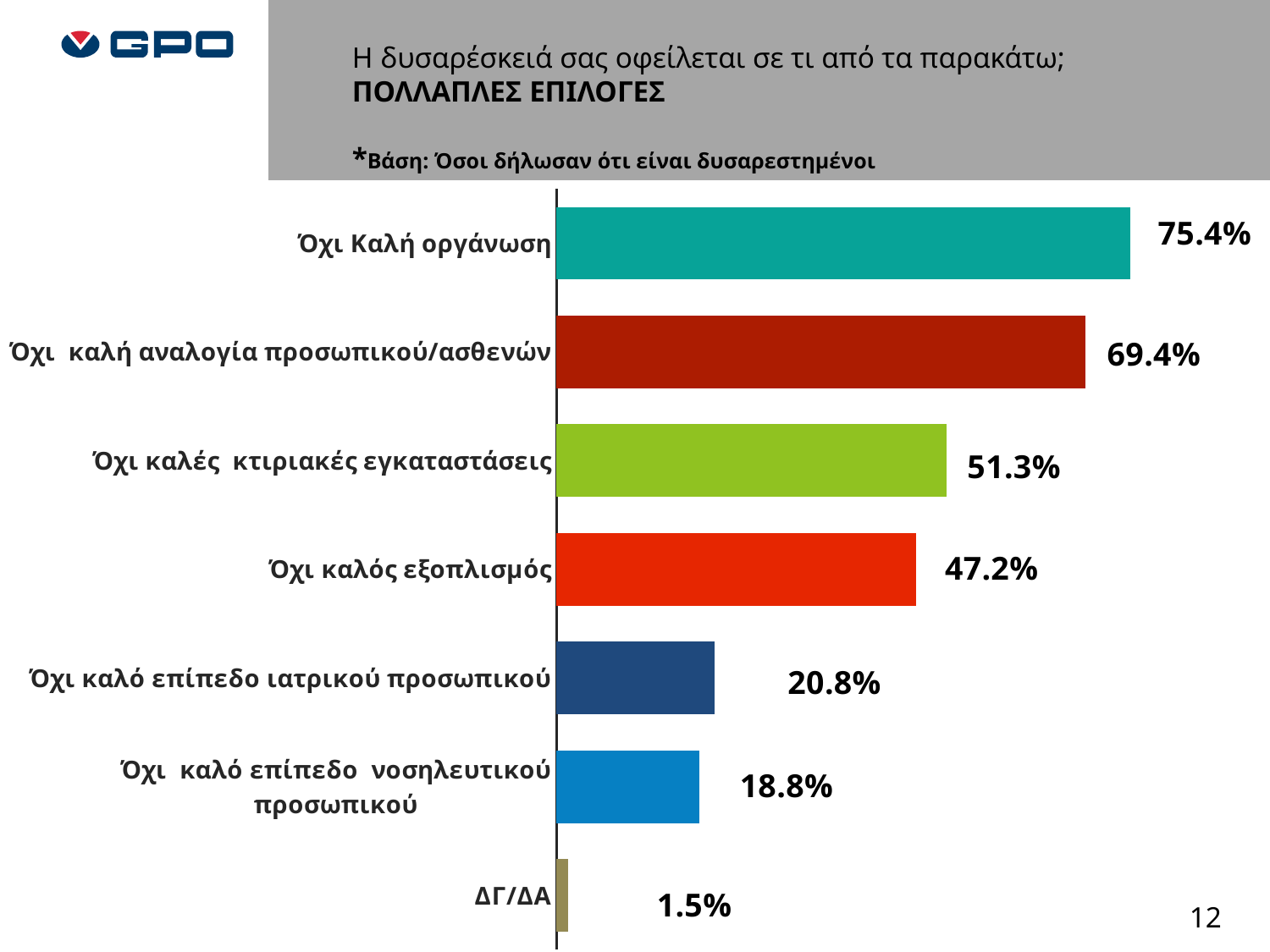
What is the value for 'Όχι καλό επίπεδο νοσηλευτικού προσωπικού'? 18.8% What is the value for 'Όχι καλός εξοπλισμός'? 47.2% What kind of chart is shown on the slide? Bar chart Which category has the highest value? Όχι Καλή οργάνωση What is the value for 'Όχι Καλή οργάνωση'? 75.4% Which category has the lowest value? ΔΓ/ΔΑ How many categories are shown in the chart? 7 What is the difference between 'Όχι καλές κτιριακές εγκαταστάσεις' and 'Όχι καλός εξοπλισμός'? 4.1% Which is larger: 'Όχι καλό επίπεδο ιατρικού προσωπικού' or 'Όχι καλό επίπεδο νοσηλευτικού προσωπικού'? Όχι καλό επίπεδο ιατρικού προσωπικού What is the value for 'ΔΓ/ΔΑ'? 1.5% What is the base (Βάση) stated for the chart? Όσοι δήλωσαν ότι είναι δυσαρεστημένοι What is the difference between 'Όχι Καλή οργάνωση' and 'Όχι καλή αναλογία προσωπικού/ασθενών'? 6.0%